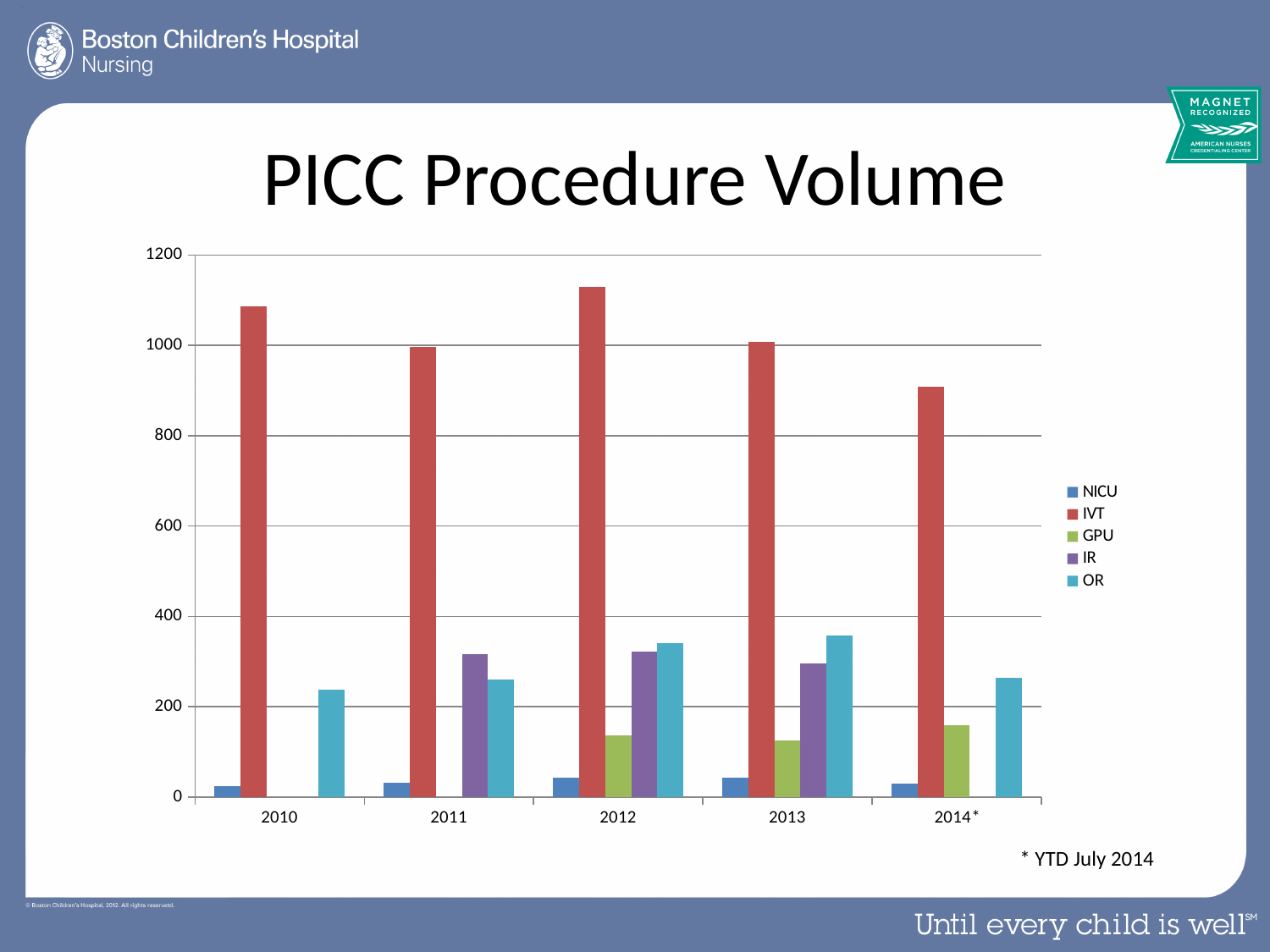
Is the OR value for 2013 greater or less than 400? less According to the footnote, what does the asterisk on 2014* mean? YTD July 2014 How many years are shown along the x axis? 5 In 2013, which is larger, the IR value or the OR value? OR Is the IVT value for 2014* greater or less than 1000? less In which year is the IVT bar the highest? 2012 What kind of chart is shown on the slide? Bar chart In 2011, which is larger, the IR value or the OR value? IR Is the IVT value for 2010 greater or less than 1000? greater How many series does the legend list? 5 In which year is the IVT bar the lowest? 2014* Which series has the tallest bar in every year shown? IVT